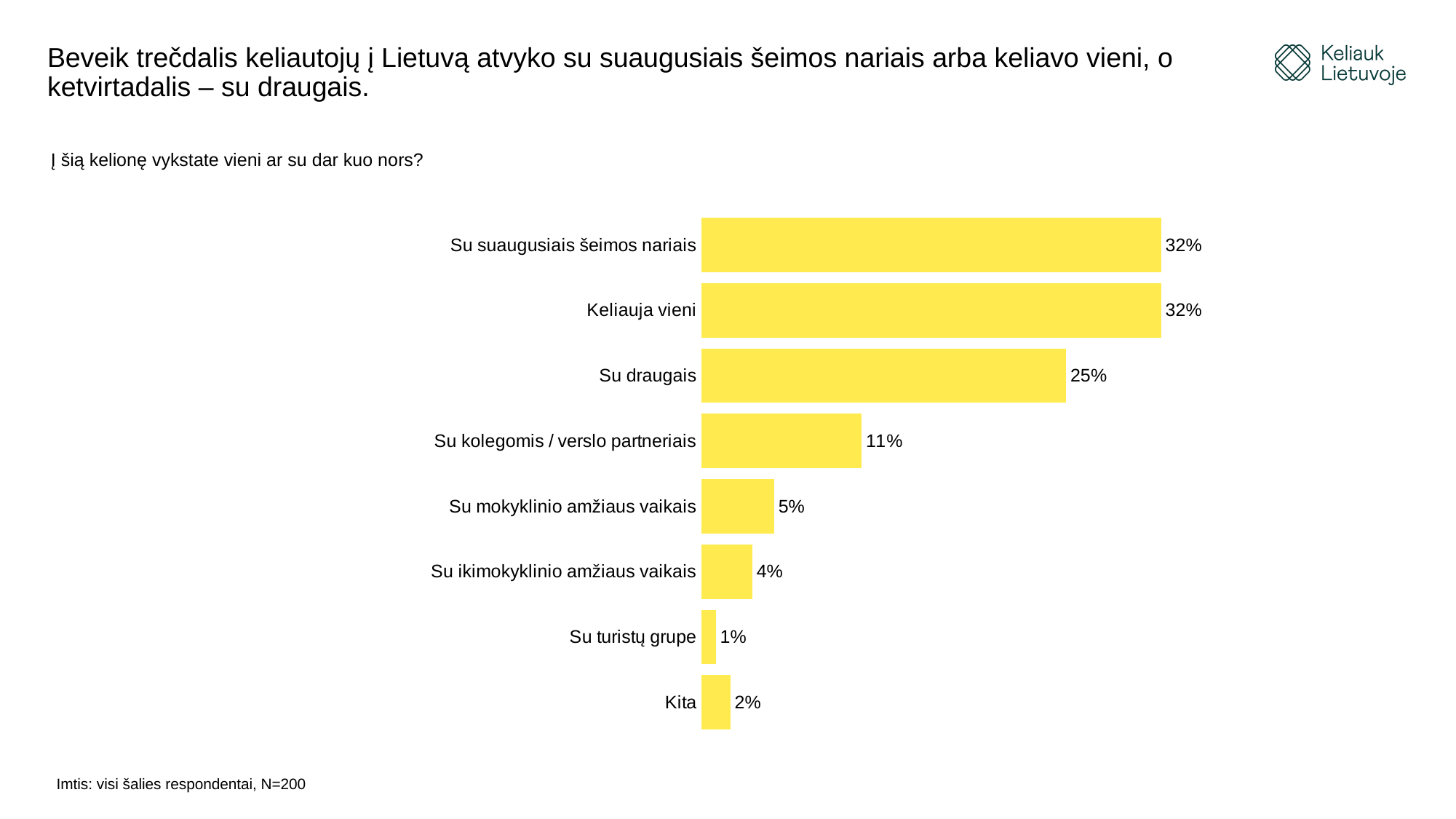
What is the value for "Su kolegomis / verslo partneriais"? 11% What is the difference between the values for "Keliauja vieni" and "Su draugais"? 7% Which category has the lowest value? Su turistų grupe What is the value for "Kita"? 2% What is the value for "Su draugais"? 25% What is the difference between the values for "Su draugais" and "Su kolegomis / verslo partneriais"? 14% Which is larger, the value for "Su mokyklinio amžiaus vaikais" or "Su ikimokyklinio amžiaus vaikais"? Su mokyklinio amžiaus vaikais Which is larger, the value for "Kita" or "Su turistų grupe"? Kita What is the value for "Su mokyklinio amžiaus vaikais"? 5% What is the survey question shown above the chart? Į šią kelionę vykstate vieni ar su dar kuo nors? How many categories are shown in the chart? 8 What kind of chart is shown on the slide? Bar chart